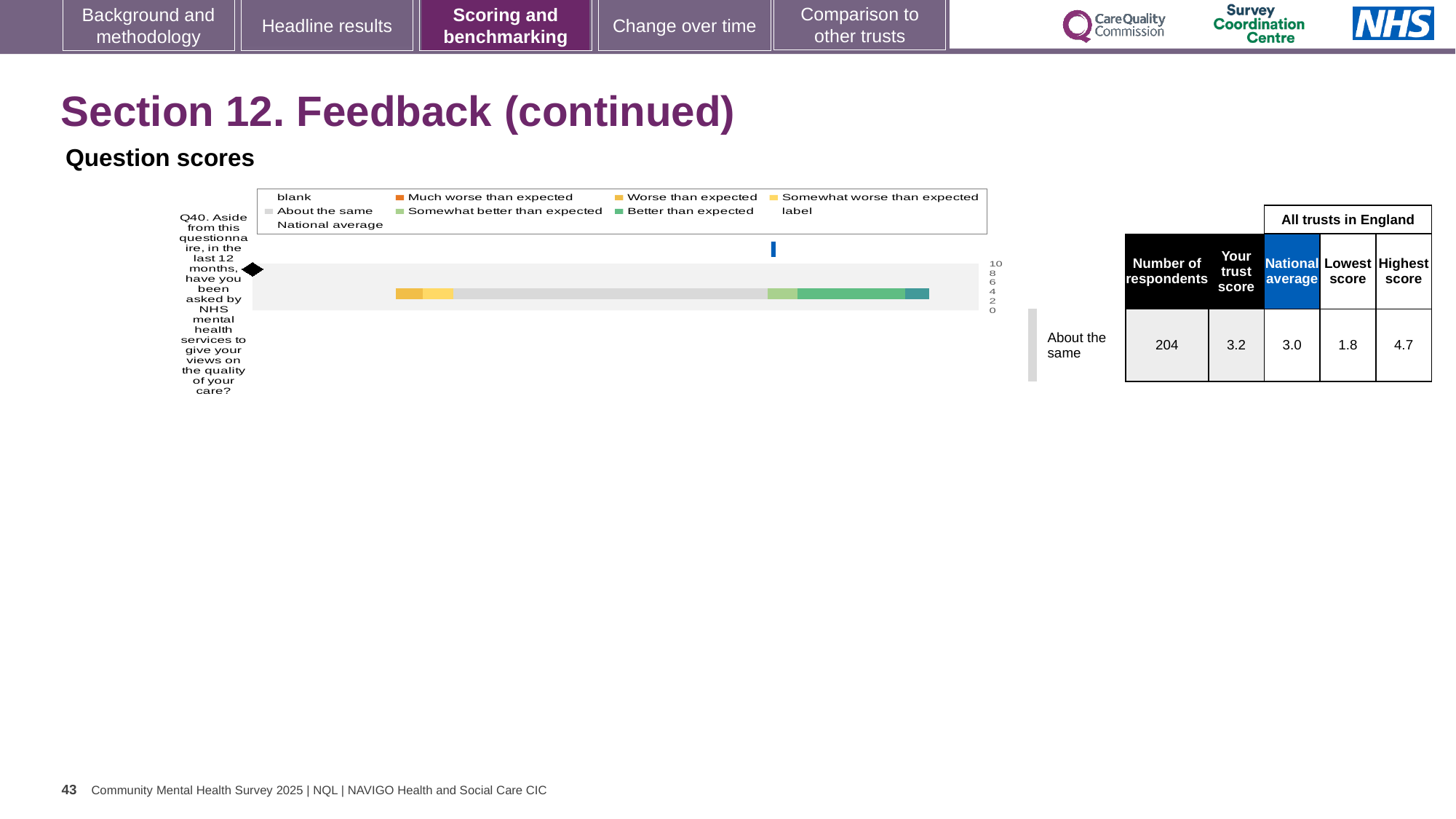
What is the national average score for Q40? 3.0 Which is larger for Q40: the trust's score or the national average? Your trust score How is the trust's result for Q40 categorised relative to expectations? About the same Which legend entry is shown in dark green in the chart? Better than expected What is the difference between the highest and lowest scores among all trusts in England for Q40? 2.9 How many respondents answered Q40? 204 How many questions (categories) are plotted in the chart? 1 What kind of chart is shown on the slide for Q40? bar chart What is the difference between the trust's score and the national average for Q40? 0.2 What is the highest score among all trusts in England for Q40? 4.7 What is the lowest score among all trusts in England for Q40? 1.8 What is the trust's score for Q40 according to the table next to the chart? 3.2